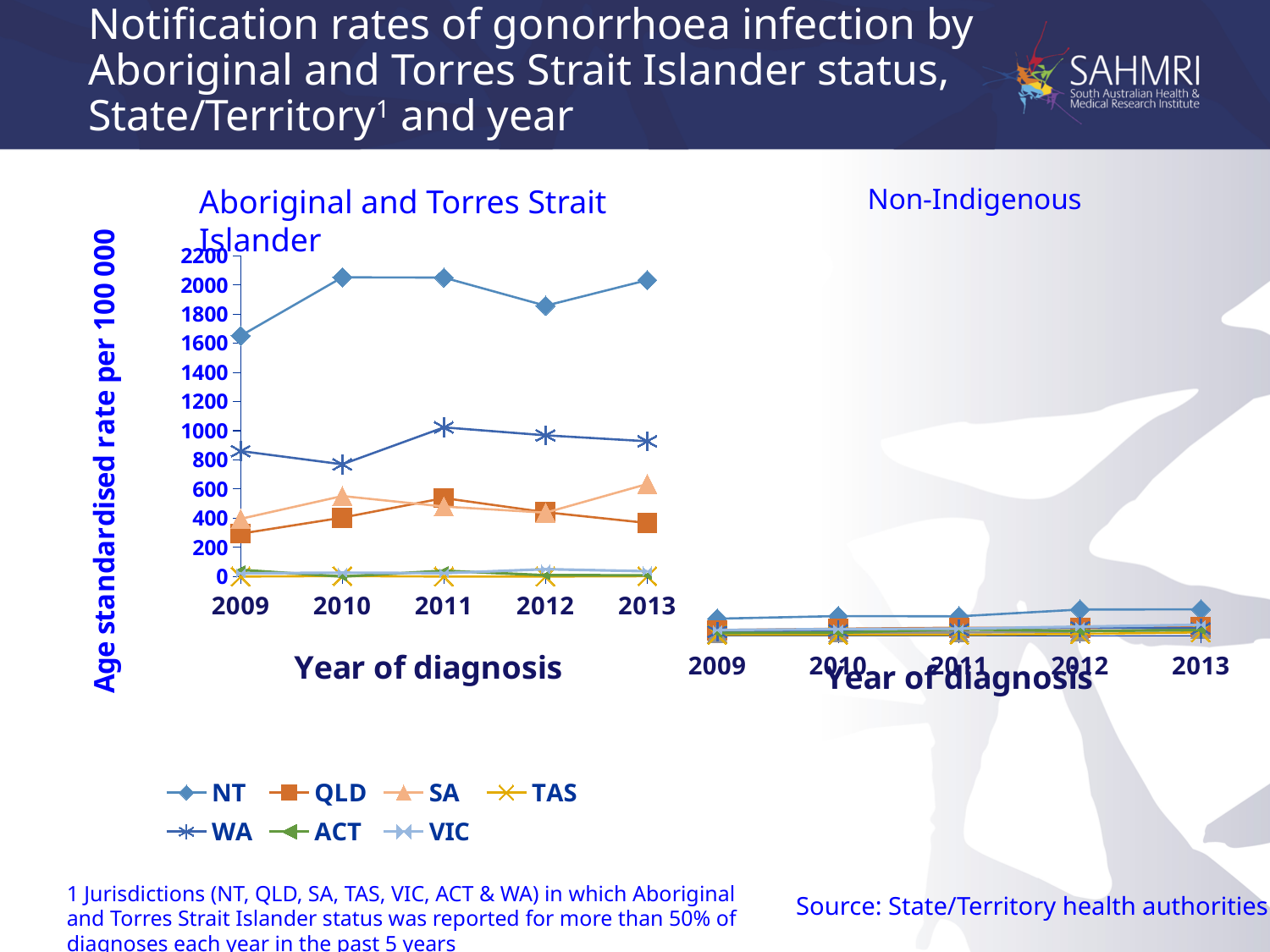
In the Aboriginal and Torres Strait Islander chart, is the NT value for 2012 greater or less than 2000? less What kind of chart is the Aboriginal and Torres Strait Islander chart? line chart In the Aboriginal and Torres Strait Islander chart, is the SA value for 2013 greater or less than 400? greater What is the y-axis title of the Aboriginal and Torres Strait Islander chart? Age standardised rate per 100 000 In the Aboriginal and Torres Strait Islander chart, is the QLD value for 2009 greater or less than 400? less How many series does the legend list? 7 What is the x-axis title of the Non-Indigenous chart? Year of diagnosis In the Aboriginal and Torres Strait Islander chart, does the NT rate rise or fall from 2009 to 2010? rise In the Aboriginal and Torres Strait Islander chart, which is larger in 2011, NT or WA? NT In the Aboriginal and Torres Strait Islander chart, which series has the highest rate in 2013? NT How many years are shown on the x axis of the Aboriginal and Torres Strait Islander chart? 5